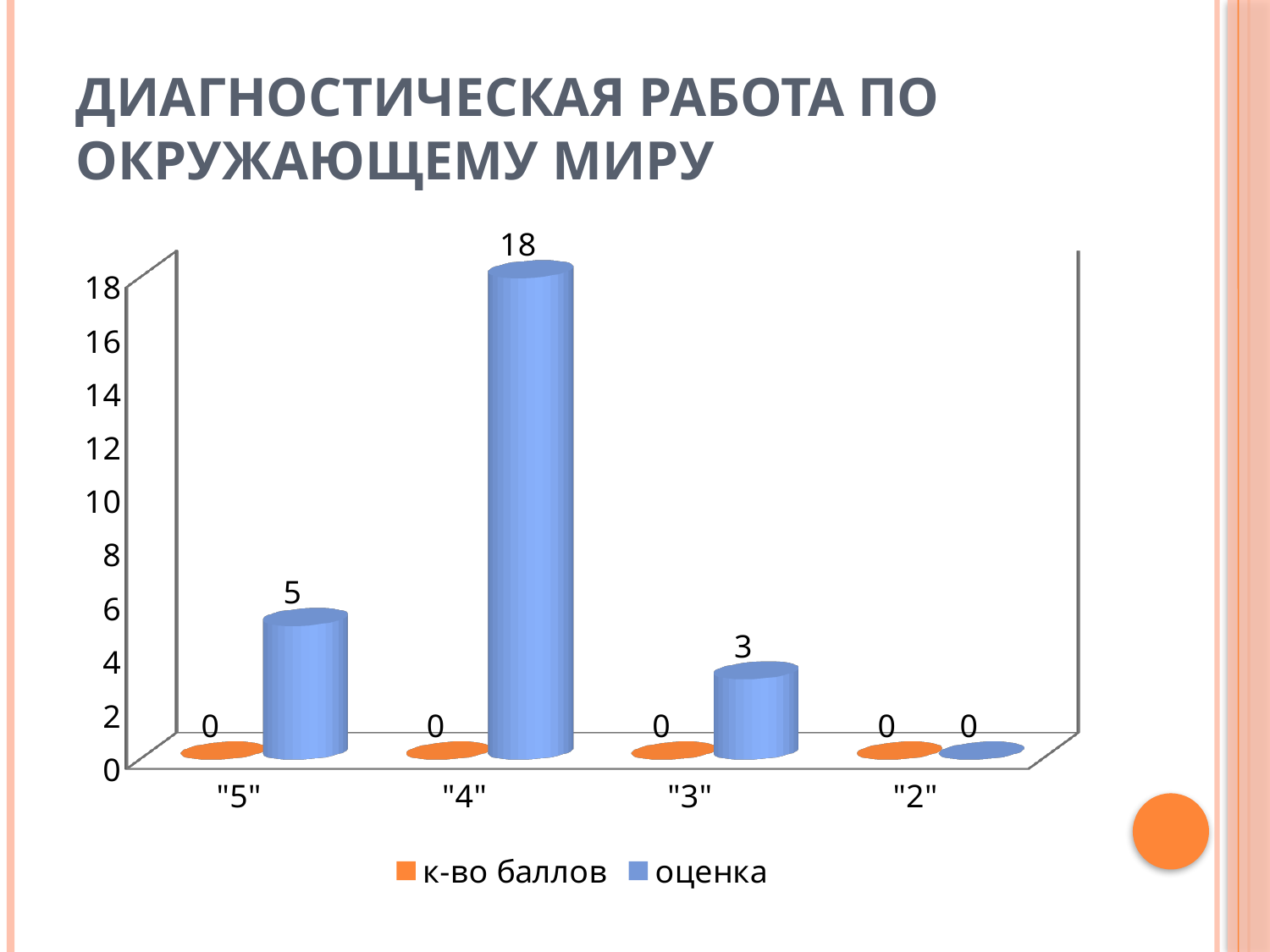
How many categories are shown on the x axis? 4 How many series does the legend list? 2 Which category has the highest value in the "оценка" series? "4" What is the value of the "оценка" series for category "5"? 5 What kind of chart is shown on the slide? Bar chart Which is larger in the "оценка" series: the value for "5" or the value for "3"? "5" What is the value of the "оценка" series for category "4"? 18 What is the difference between the "оценка" values for categories "4" and "5"? 13 What is the value of the "оценка" series for category "2"? 0 Which category has the lowest value in the "оценка" series? "2" What is the value of the "оценка" series for category "3"? 3 What is the value of the "к-во баллов" series for category "5"? 0